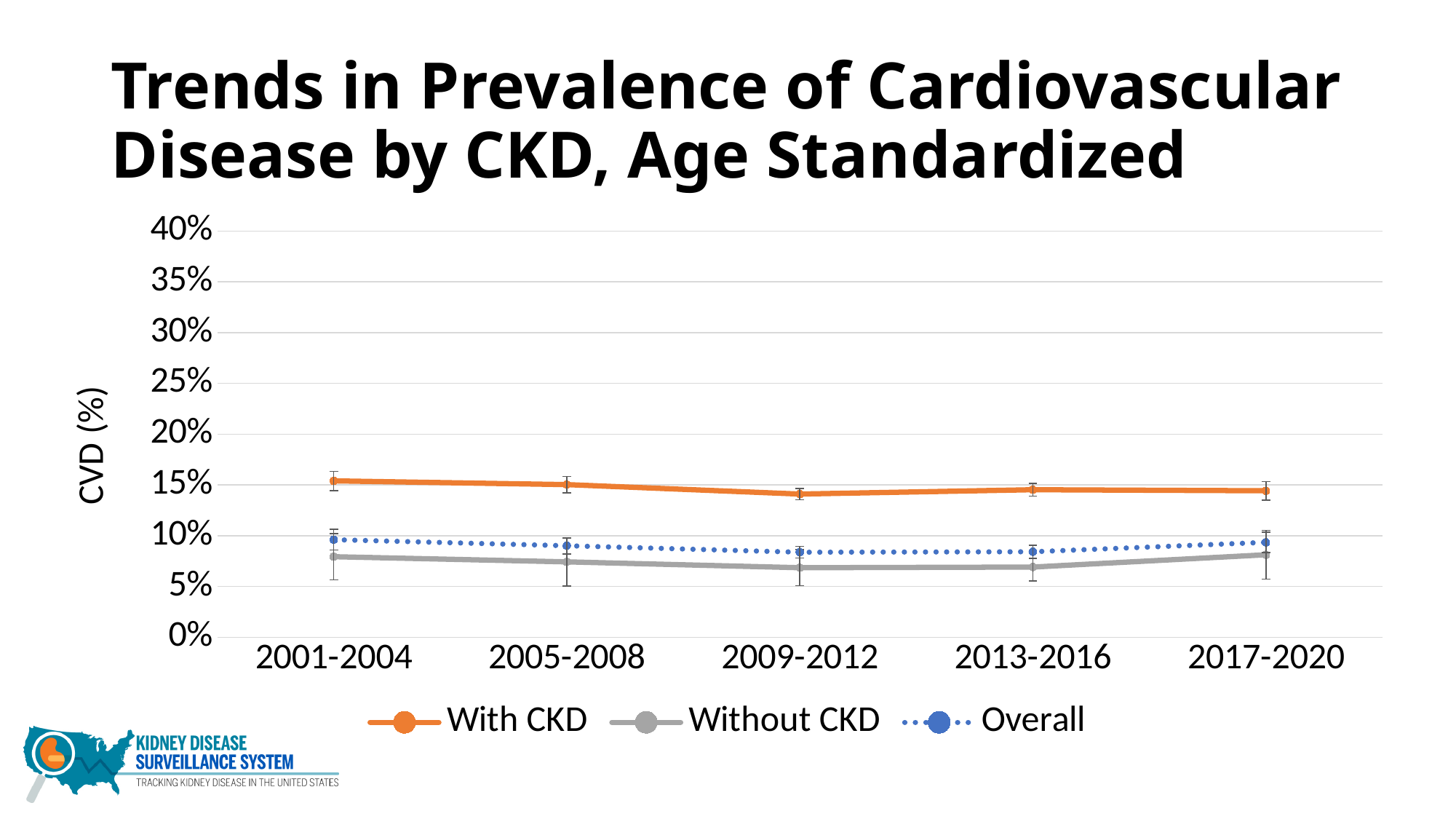
How many time periods are shown on the x axis? 5 Is the value for Without CKD in 2009-2012 greater or less than 10%? less Which series has the highest CVD prevalence across all periods? With CKD Is the value for With CKD in 2001-2004 greater or less than 10%? greater What is the label on the y axis? CVD (%) In 2017-2020, which is larger: the value for With CKD or the value for Without CKD? With CKD Is the value for With CKD in 2009-2012 greater or less than 15%? less Does the With CKD line rise or fall from 2001-2004 to 2009-2012? Fall What kind of chart is shown on the slide? Line chart How many series does the legend list? 3 Which series has the lowest CVD prevalence across all periods? Without CKD